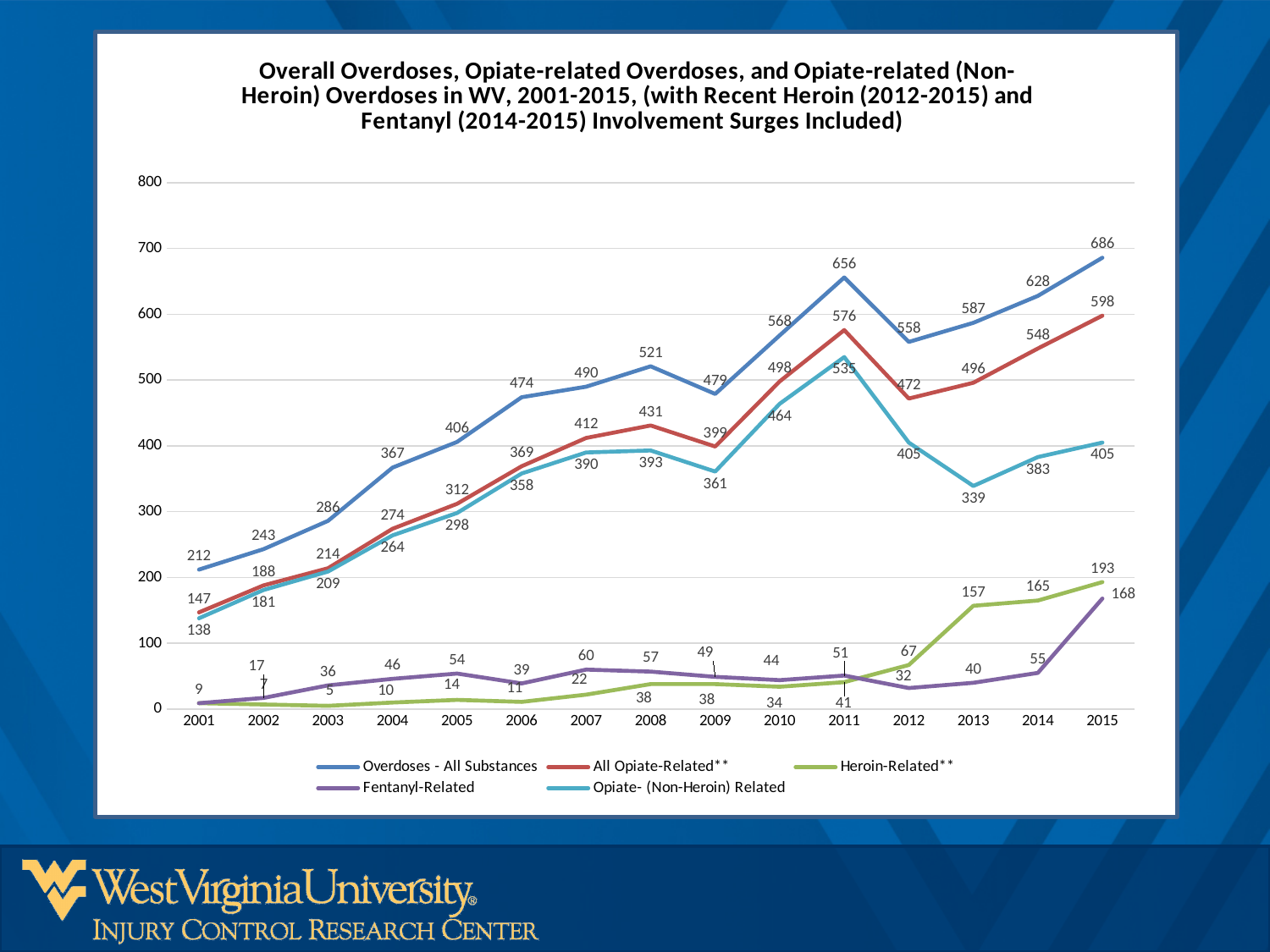
What is the value for Fentanyl-Related overdoses in 2015? 168 In which year is the Opiate- (Non-Heroin) Related series at its lowest? 2001 What is the value for Opiate- (Non-Heroin) Related overdoses in 2013? 339 What is the difference between Overdoses - All Substances and All Opiate-Related overdoses in 2015? 88 In which year is the Overdoses - All Substances series at its highest? 2015 How many years are plotted along the x axis? 15 What is the value for Heroin-Related overdoses in 2013? 157 What is the value for Overdoses - All Substances in 2011? 656 How many series does the legend list? 5 What kind of chart is shown on the slide? line chart What is the value for All Opiate-Related overdoses in 2015? 598 In 2015, which is larger: Heroin-Related or Fentanyl-Related overdoses? Heroin-Related